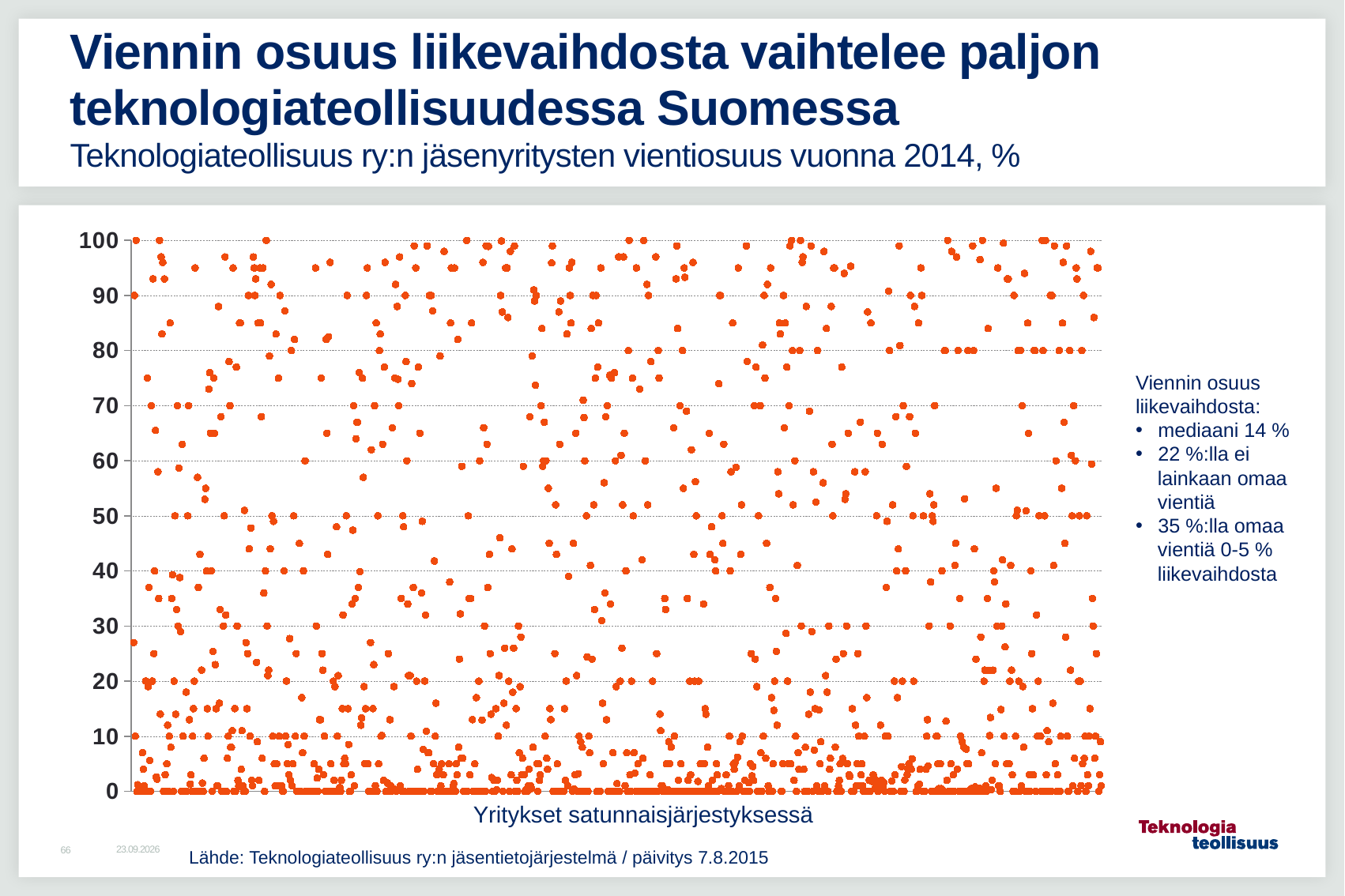
Which year does the chart's data refer to? 2014 According to the text beside the chart, what share of companies have exports of 0-5 % of turnover? 35 % What kind of chart is shown on the slide? scatter chart What is the lowest export share value that plotted points reach? 0 What is the highest value shown on the vertical axis of the chart? 100 According to the text beside the chart, what is the median export share of turnover? 14 % What is the label of the horizontal axis of the chart? Yritykset satunnaisjärjestyksessä Is the median export share stated on the slide greater or less than 20? less What is the highest export share value that any plotted point reaches? 100 According to the text beside the chart, what share of companies have no exports at all? 22 %